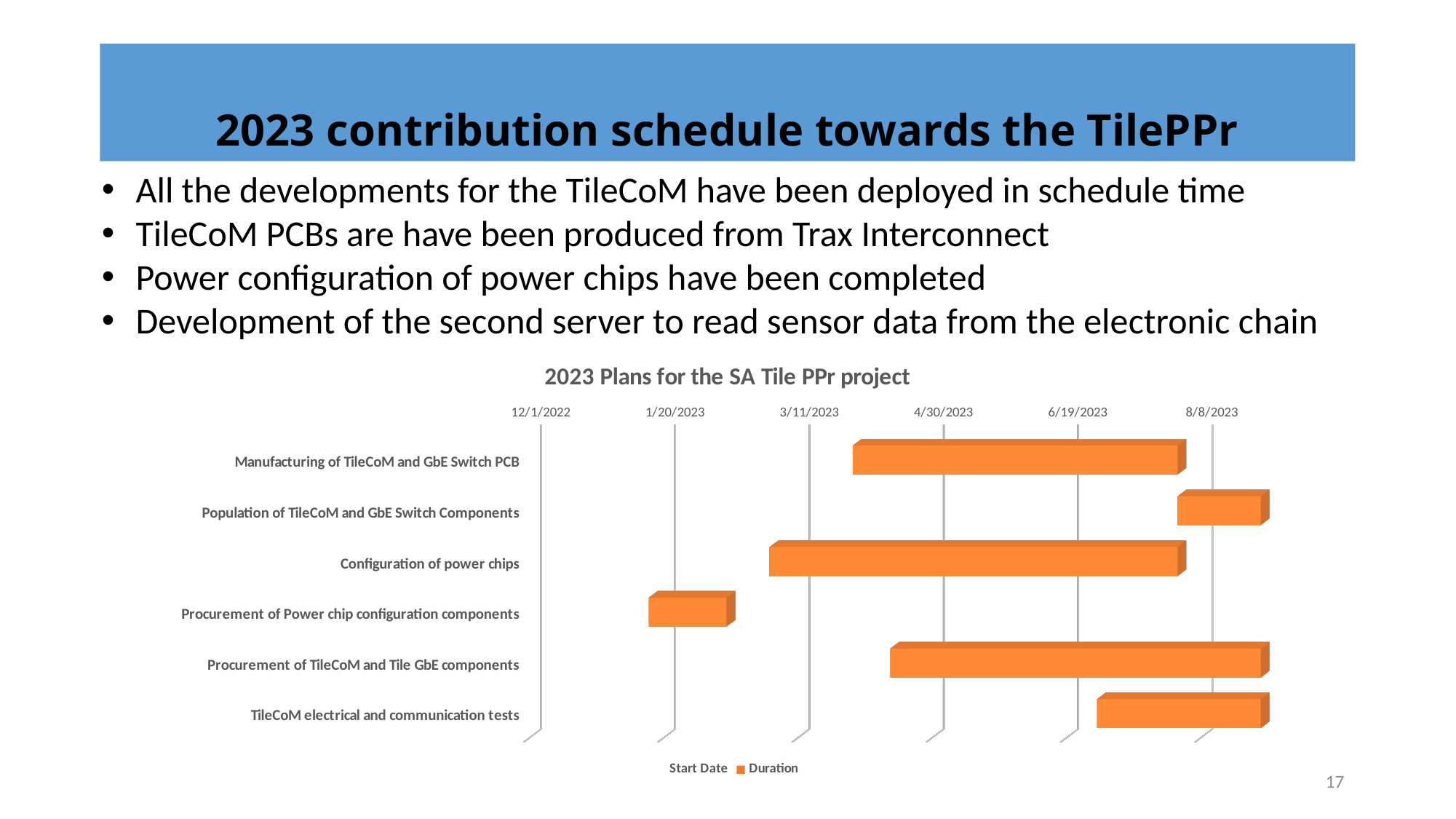
Does the bar for Manufacturing of TileCoM and GbE Switch PCB start before or after 3/11/2023? after What is the first date label shown on the horizontal axis of the chart? 12/1/2022 Which task starts earlier, Manufacturing of TileCoM and GbE Switch PCB or Configuration of power chips? Configuration of power chips What kind of chart is shown on the slide? Bar chart (Gantt-style horizontal bar chart) What are the two entries in the chart legend? Start Date and Duration How many series does the chart legend list? 2 Does the bar for TileCoM electrical and communication tests start before or after 6/19/2023? after Which task starts earliest in the chart? Procurement of Power chip configuration components How many tasks (categories) are listed on the vertical axis of the chart? 6 What is the title of the chart? 2023 Plans for the SA Tile PPr project Does the bar for Procurement of Power chip configuration components start before or after 1/20/2023? before Which task starts latest in the chart? Population of TileCoM and GbE Switch Components